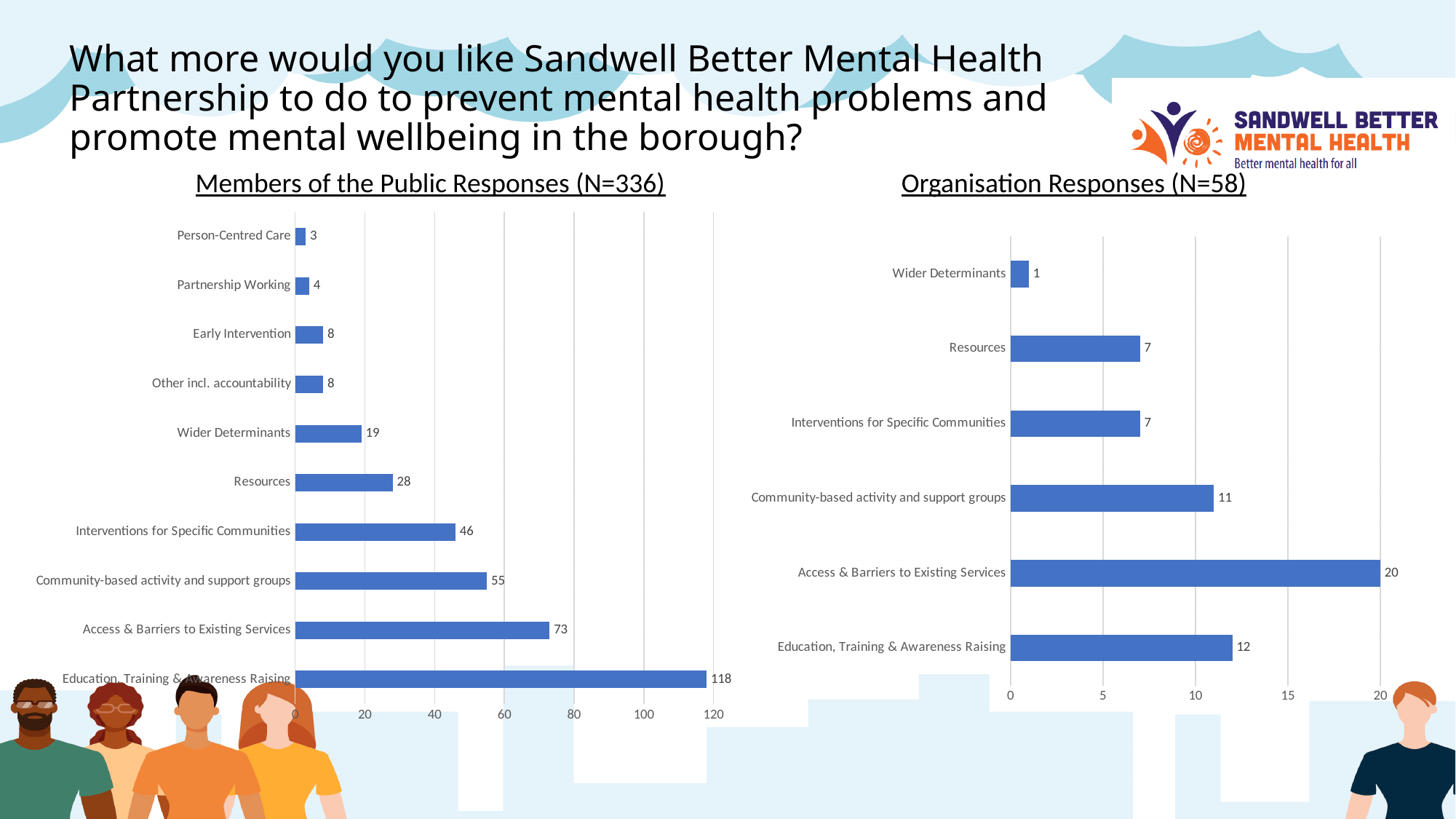
What type of chart is the Organisation Responses chart? Bar chart In the Organisation Responses chart, how many categories are shown? 6 In the Organisation Responses chart, which category has the lowest value? Wider Determinants In the Members of the Public Responses chart, which category has the highest value? Education, Training & Awareness Raising In the Members of the Public Responses chart, what is the difference between Education, Training & Awareness Raising and Access & Barriers to Existing Services? 45 In the Organisation Responses chart, which category has the highest value? Access & Barriers to Existing Services In the Members of the Public Responses chart, which category has the lowest value? Person-Centred Care In the Members of the Public Responses chart, what is the value for Wider Determinants? 19 In the Members of the Public Responses chart, how many categories are shown? 10 In the Organisation Responses chart, what is the value for Community-based activity and support groups? 11 In the Organisation Responses chart, which is larger: Education, Training & Awareness Raising or Resources? Education, Training & Awareness Raising In the Members of the Public Responses chart, what is the value for Access & Barriers to Existing Services? 73